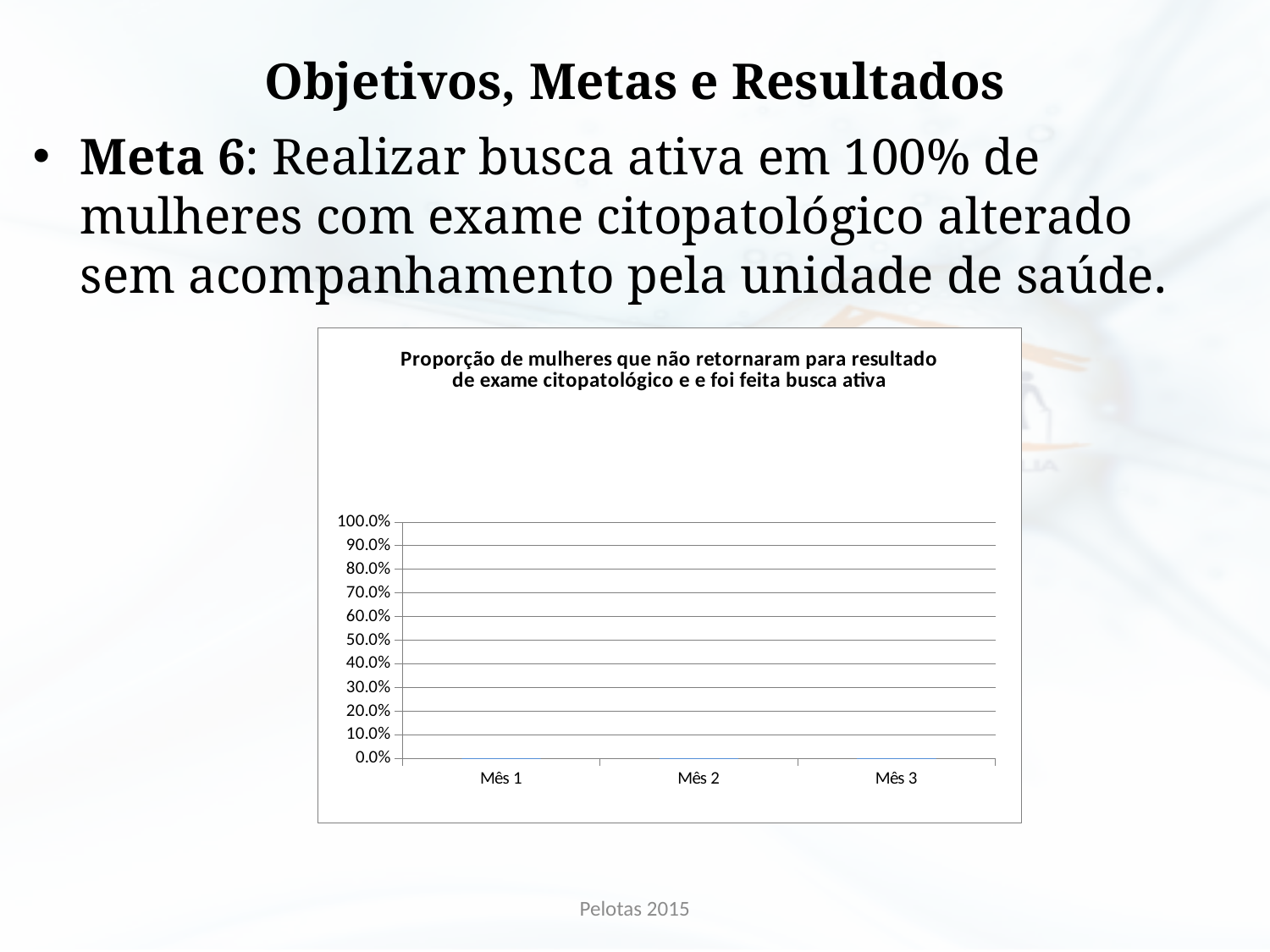
Is the value for Mês 1 greater or less than 10.0%? less What are the category labels on the x axis of the chart? Mês 1, Mês 2, Mês 3 What is the highest value shown on the y axis of the chart? 100.0% What is the title of the chart? Proporção de mulheres que não retornaram para resultado de exame citopatológico e e foi feita busca ativa What value does the bar for Mês 3 land on? 0.0% Is the value for Mês 2 greater or less than 50.0%? less Is the value for Mês 3 greater or less than 10.0%? less How many categories are shown on the x axis of the chart? 3 What is the lowest value shown on the y axis of the chart? 0.0% Do the values rise, fall, or stay the same from Mês 1 to Mês 3? stay the same What value does the bar for Mês 1 land on? 0.0%